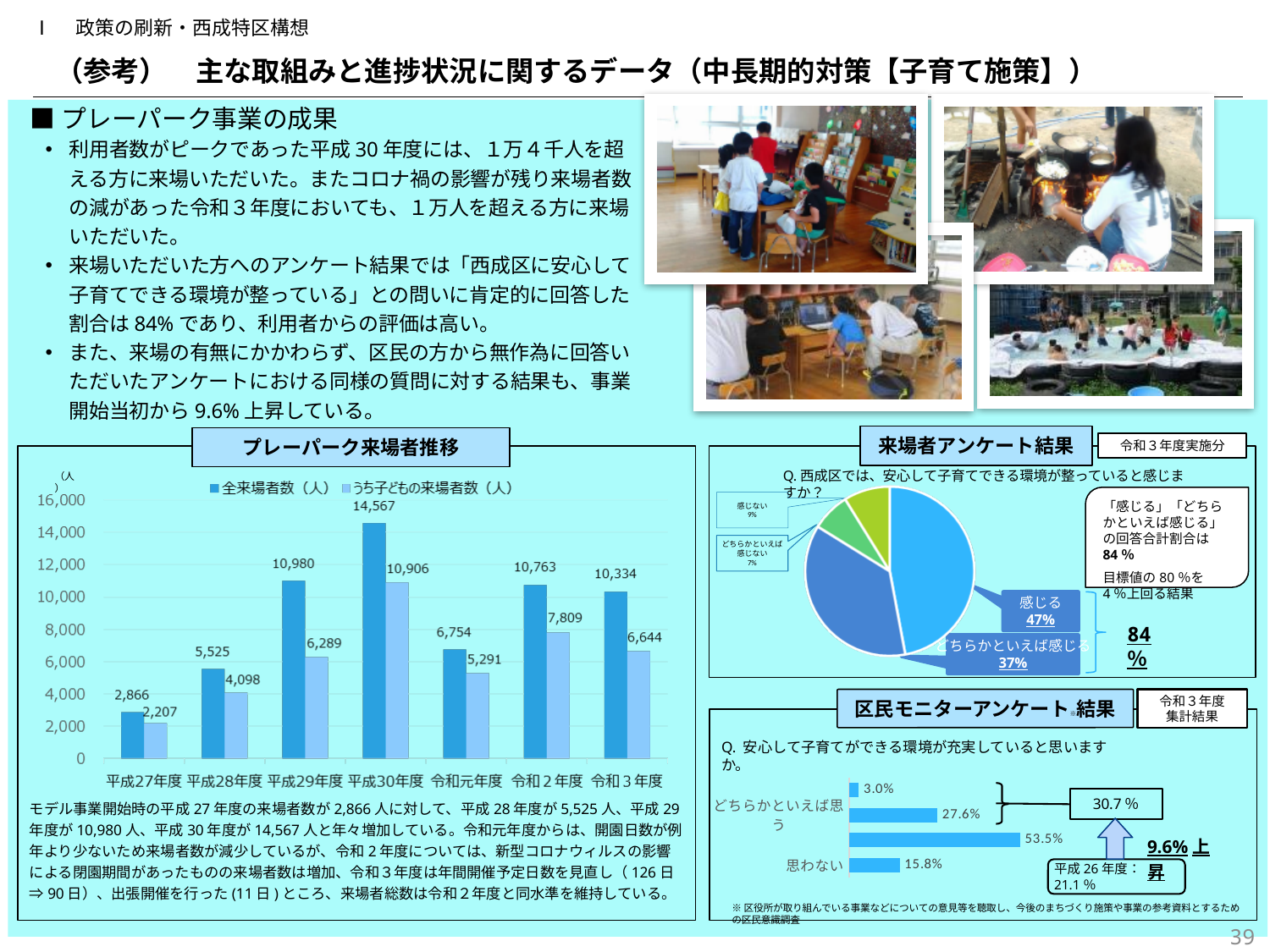
In the プレーパーク来場者推移 chart, does the 全来場者数 rise or fall from 平成27年度 to 平成30年度? rise In the プレーパーク来場者推移 chart, what is the うち子どもの来場者数 for 令和2年度? 7,809 In the プレーパーク来場者推移 chart, what is the 全来場者数 for 平成30年度? 14,567 In the プレーパーク来場者推移 chart, how many fiscal years are shown on the x axis? 7 In the プレーパーク来場者推移 chart, what is the difference between the 全来場者数 for 平成30年度 and 令和元年度? 7,813 In the プレーパーク来場者推移 chart, how many series does the legend list? 2 In the プレーパーク来場者推移 chart, which fiscal year has the lowest 全来場者数? 平成27年度 In the プレーパーク来場者推移 chart, which fiscal year has the highest 全来場者数? 平成30年度 In the 区民モニターアンケート結果 chart, what is the value for 思わない? 15.8% In the プレーパーク来場者推移 chart, which is larger, the 全来場者数 for 令和2年度 or for 令和3年度? 令和2年度 In the 来場者アンケート結果 pie chart, what share of responses is 感じる? 47% What kind of chart is the プレーパーク来場者推移 chart? bar chart